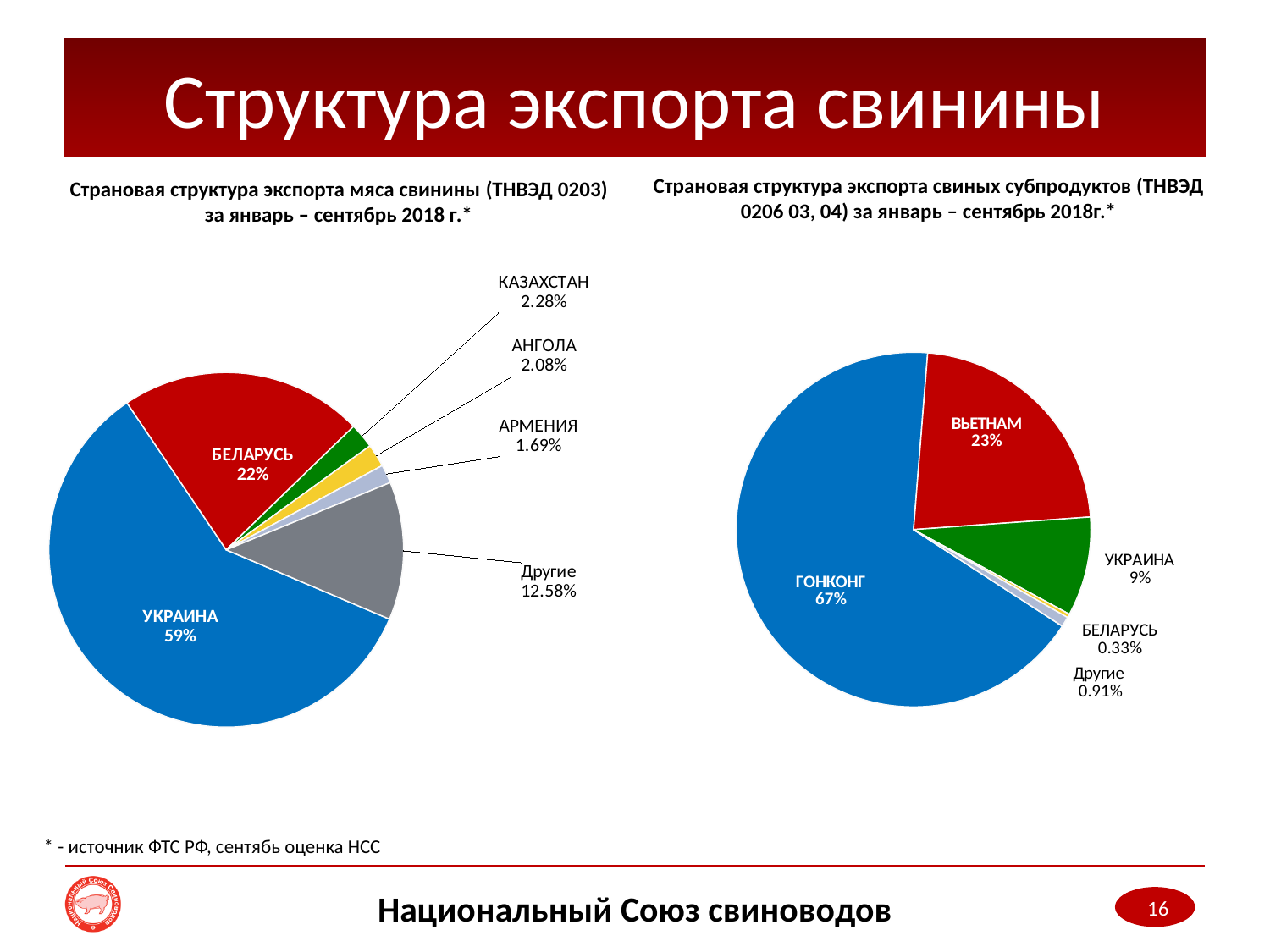
On the right pie chart (export of pork by-products), which is larger: the share of Украина or the share of Другие? Украина On the left pie chart (export of pork meat), what share does Беларусь have? 22% On the left pie chart (export of pork meat), which labelled category has the smallest share? Армения On the right pie chart (export of pork by-products, ТНВЭД 0206 03, 04), what share does Гонконг have? 67% On the left pie chart (export of pork meat), what share does Казахстан have? 2.28% What type of chart is used on this slide? Pie chart On the right pie chart (export of pork by-products), what share does Вьетнам have? 23% On the left pie chart (export of pork meat), how many slices are labelled? 6 On the right pie chart (export of pork by-products), what share does Беларусь have? 0.33% On the left pie chart (export of pork meat), what share does Армения have? 1.69% On the left pie chart (export of pork meat, ТНВЭД 0203), what share does Украина have? 59% On the left pie chart (export of pork meat), which country has the largest share? Украина